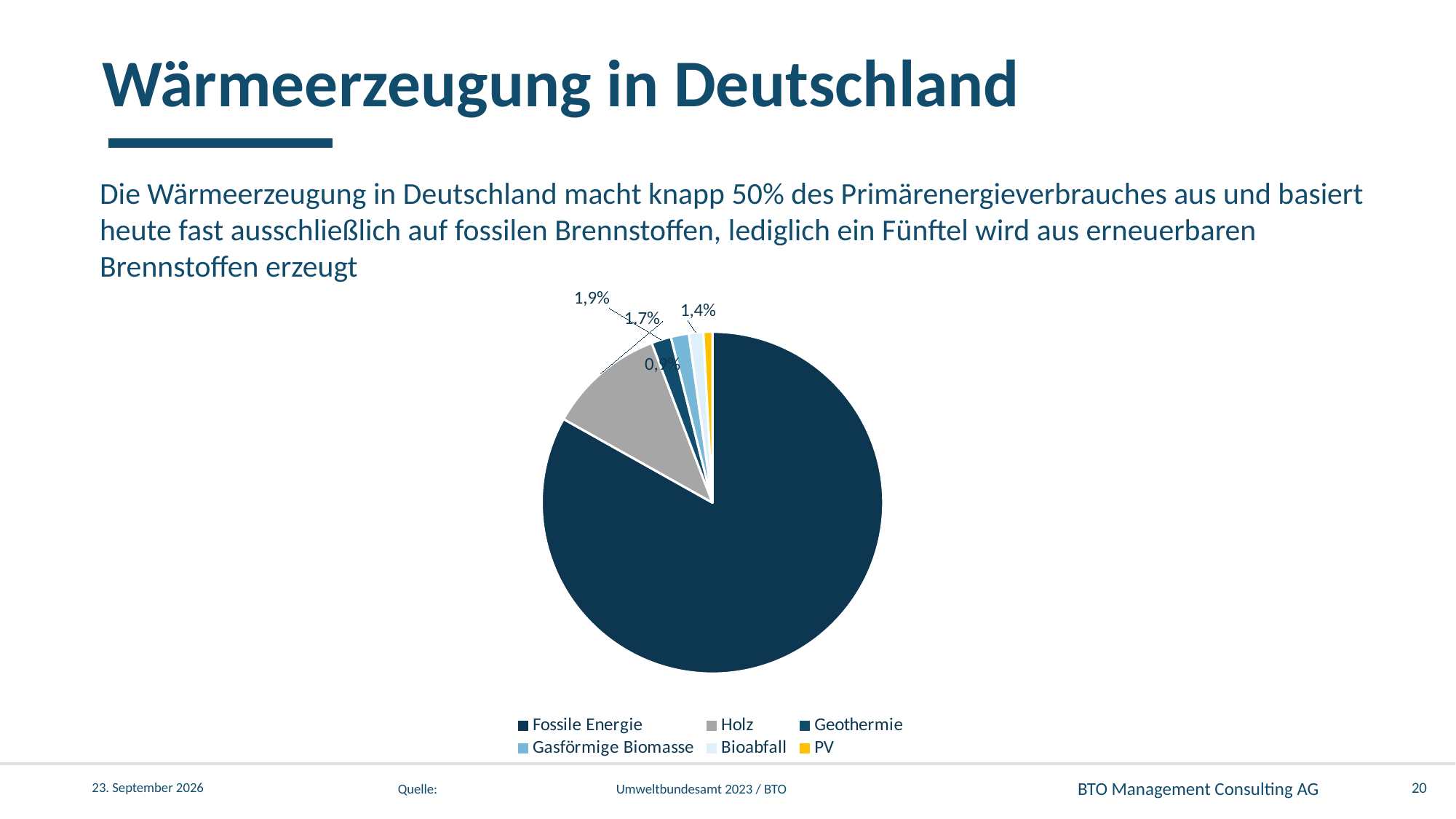
Which category has the second-largest slice in the pie chart? Holz Which slice is larger, Holz or PV? Holz Which slice is larger, Fossile Energie or Holz? Fossile Energie Which category has the largest slice in the pie chart? Fossile Energie Does the Fossile Energie slice make up more or less than half of the pie? More What colour is the PV slice in the pie chart? Yellow What is the title of the slide containing the pie chart? Wärmeerzeugung in Deutschland What kind of chart is shown on the slide? Pie chart How many categories does the legend of the pie chart list? 6